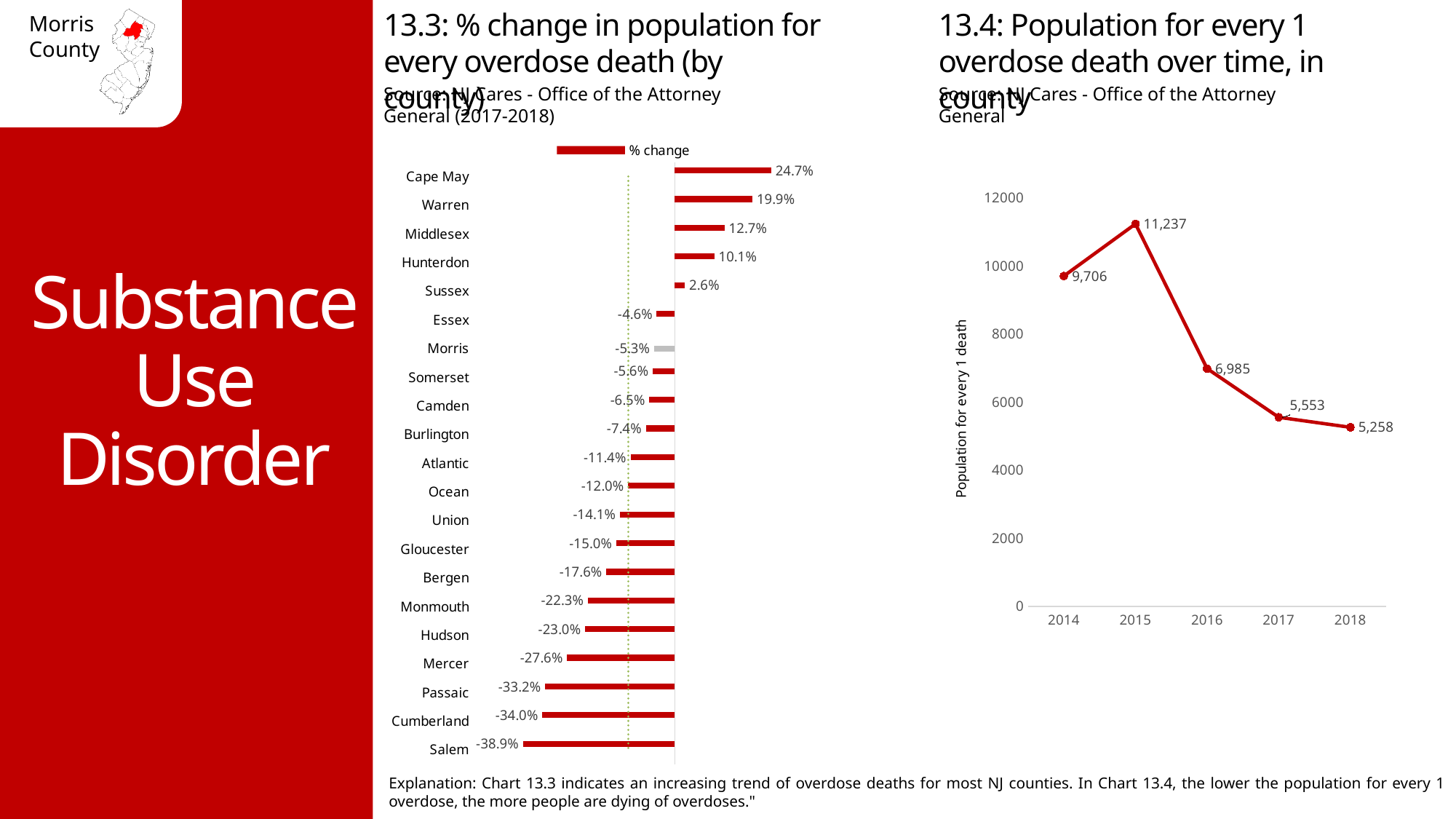
In chart 13.3, what is the difference between the % change for Warren and Middlesex? 7.2 percentage points In chart 13.3, which county has the highest % change? Cape May In chart 13.4, what is the population for every 1 overdose death in 2015? 11,237 In chart 13.3, which county has the lowest % change? Salem In chart 13.4, what is the population for every 1 overdose death in 2018? 5,258 In chart 13.3, how many counties are shown? 21 In chart 13.4, which year has the highest population for every 1 overdose death? 2015 What kind of chart is chart 13.4? Line chart In chart 13.3, what is the % change for Cape May? 24.7% In chart 13.3, what is the % change for Morris? -5.3% In chart 13.4, what is the difference between the 2014 and 2016 values? 2,721 In chart 13.3, which has a larger % change, Hudson or Mercer? Hudson